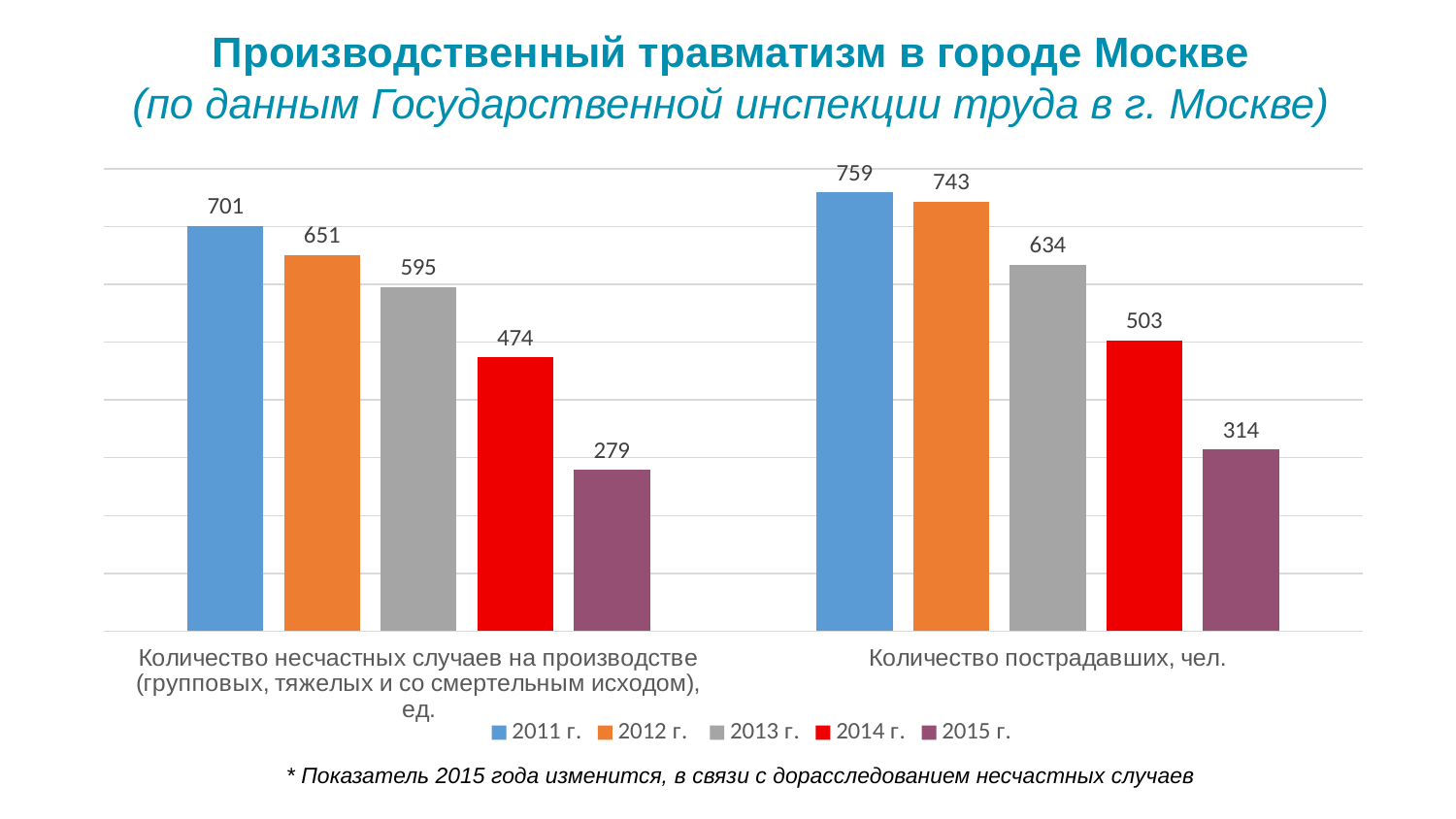
How many series does the legend list? 5 What is the value for 2011 г. in the category "Количество несчастных случаев на производстве (групповых, тяжелых и со смертельным исходом), ед."? 701 Which year has the highest value in the category "Количество пострадавших, чел."? 2011 г. What is the difference between the 2011 г. and 2015 г. values in the category "Количество пострадавших, чел."? 445 Which is larger: the 2013 г. value for "Количество несчастных случаев на производстве" or the 2014 г. value for "Количество пострадавших, чел."? 2013 г. value for "Количество несчастных случаев на производстве" (595) What is the value for 2013 г. in the category "Количество пострадавших, чел."? 634 Which year has the lowest value in the category "Количество несчастных случаев на производстве (групповых, тяжелых и со смертельным исходом), ед."? 2015 г. What is the value for 2015 г. in the category "Количество пострадавших, чел."? 314 How many categories are shown on the x axis? 2 What is the difference between the 2012 г. and 2014 г. values in the category "Количество несчастных случаев на производстве (групповых, тяжелых и со смертельным исходом), ед."? 177 Do the values from 2011 г. to 2015 г. rise or fall in the category "Количество пострадавших, чел."? Fall What kind of chart is shown on the slide? Bar chart